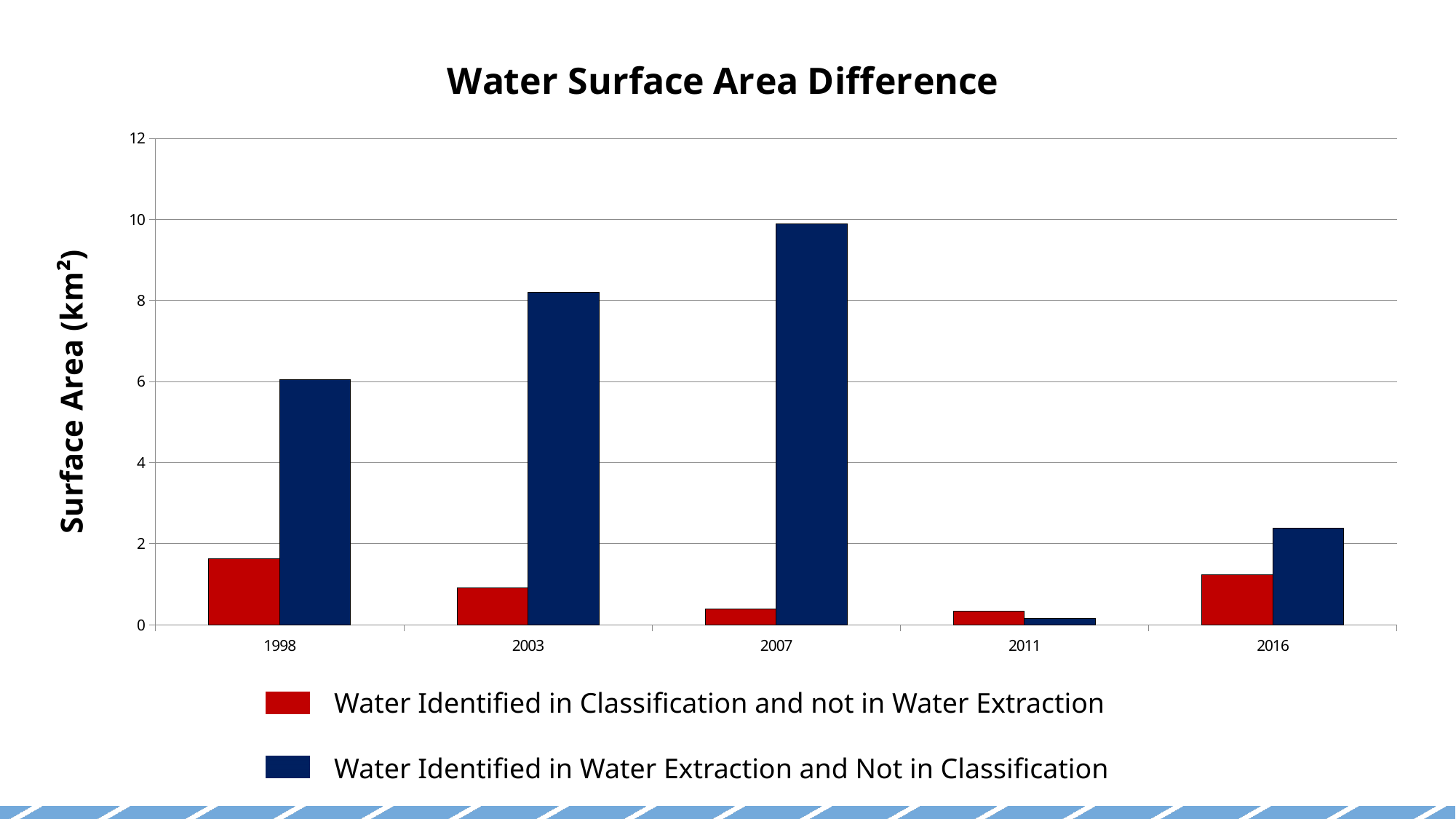
Is the 2007 value for 'Water Identified in Water Extraction and Not in Classification' greater or less than 8? greater Does the value for 'Water Identified in Water Extraction and Not in Classification' rise or fall from 1998 to 2007? rise What is the label of the y axis? Surface Area (km²) How many years are shown on the x axis of the chart? 5 What type of chart is shown on the slide? bar chart In which year is the value for 'Water Identified in Classification and not in Water Extraction' highest? 1998 In which year is the value for 'Water Identified in Water Extraction and Not in Classification' lowest? 2011 In which year is the value for 'Water Identified in Water Extraction and Not in Classification' highest? 2007 In 2011, which series has the larger value: 'Water Identified in Classification and not in Water Extraction' or 'Water Identified in Water Extraction and Not in Classification'? Water Identified in Classification and not in Water Extraction What is the title of the chart? Water Surface Area Difference Is the 1998 value for 'Water Identified in Classification and not in Water Extraction' greater or less than 2? less How many series does the legend list? 2